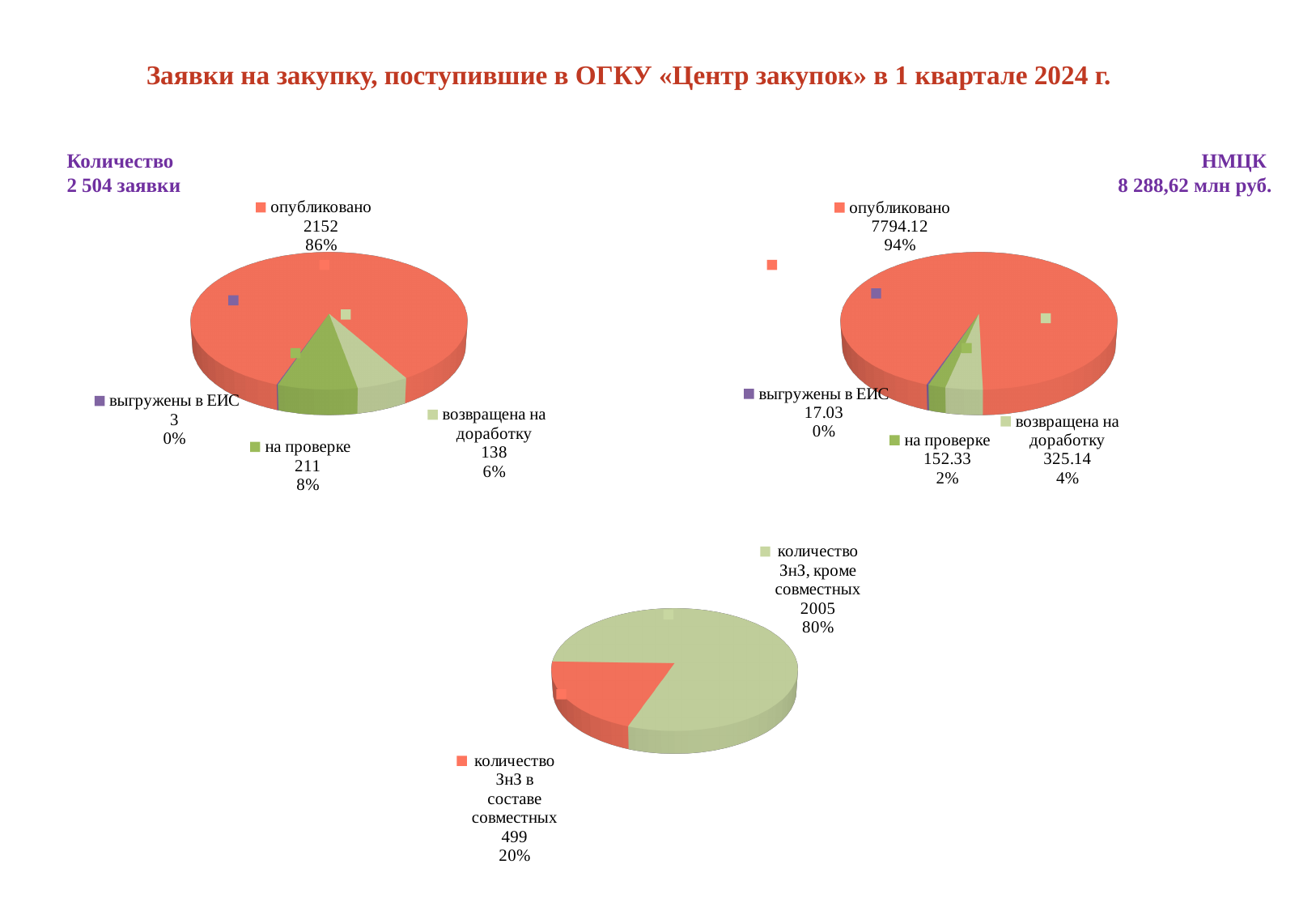
What type of chart is used for the bottom chart on the slide? Pie chart In the top-right pie chart (НМЦК), which is larger: «на проверке» or «возвращена на доработку»? возвращена на доработку In the top-right pie chart (НМЦК), what share of the pie is «опубликовано»? 94% In the bottom pie chart, what is the value for «количество ЗнЗ в составе совместных»? 499 In the top-right pie chart (НМЦК), how many slices are there? 4 In the top-right pie chart (НМЦК), what is the value for «возвращена на доработку»? 325.14 What total is shown above the top-right chart under the heading НМЦК? 8 288,62 млн руб. In the bottom pie chart, what share of the pie is «количество ЗнЗ, кроме совместных»? 80% In the top-left pie chart (Количество), which category has the smallest value? выгружены в ЕИС In the top-left pie chart (Количество), what share of the pie is «на проверке»? 8% In the top-left pie chart (Количество), what is the difference between «на проверке» and «возвращена на доработку»? 73 In the top-left pie chart (Количество), what is the value for «опубликовано»? 2152